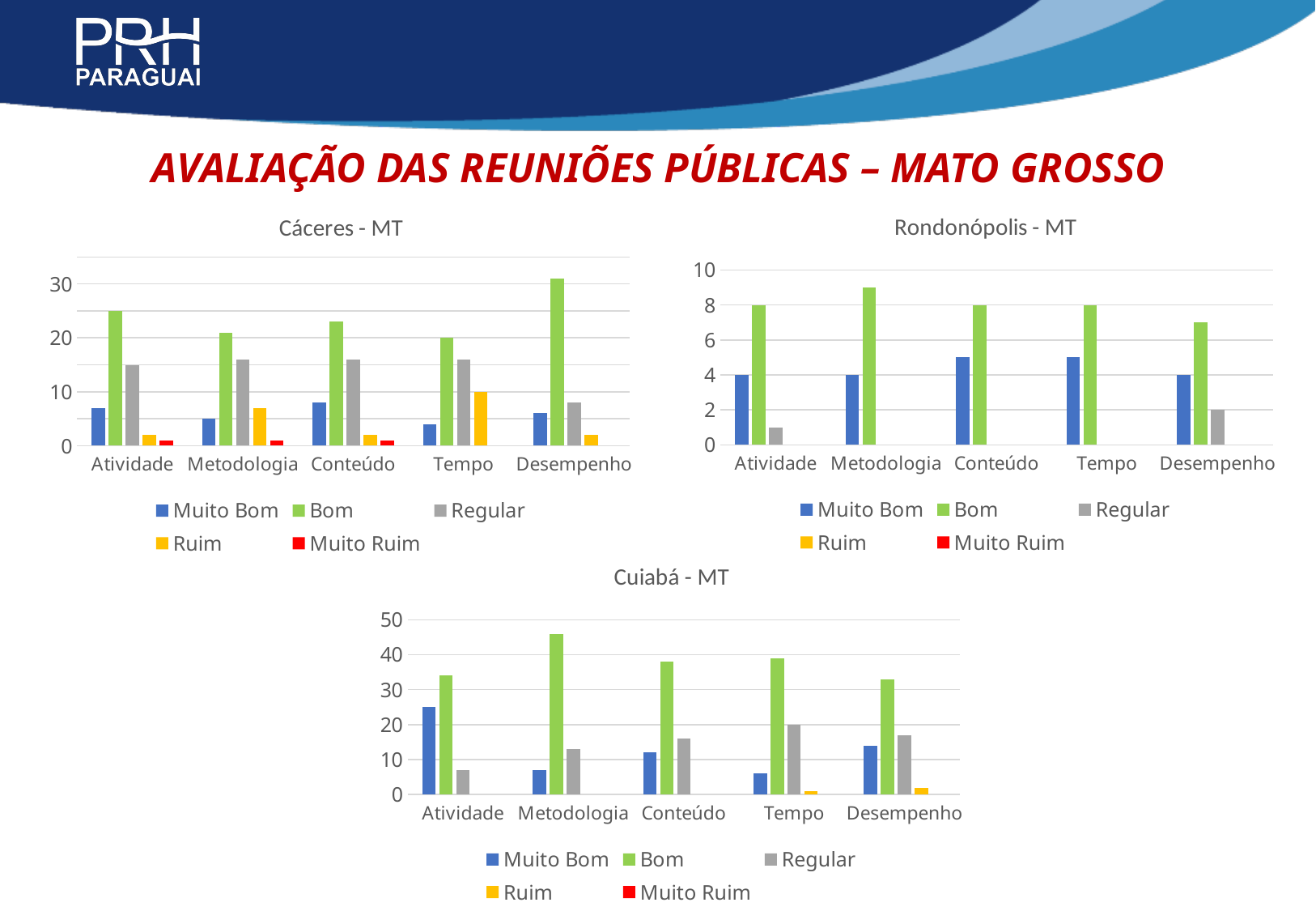
In the Cáceres - MT chart, is the Bom value for Atividade greater or less than 20? greater What type of chart is the Cáceres - MT chart? bar chart In the Rondonópolis - MT chart, which category has the highest Bom value? Metodologia In the Cuiabá - MT chart, is the Bom value for Metodologia greater or less than 40? greater How many charts are shown on the slide? 3 How many categories are on the x axis of the Rondonópolis - MT chart? 5 In the Cáceres - MT chart, which category has the highest Bom value? Desempenho In the Rondonópolis - MT chart, what is the value of Bom for Tempo? 8 How many series does the legend of the Cuiabá - MT chart list? 5 In the Rondonópolis - MT chart, what is the value of Regular for Desempenho? 2 In the Rondonópolis - MT chart, what is the value of Muito Bom for Atividade? 4 In the Cuiabá - MT chart, which category has the highest Muito Bom value? Atividade